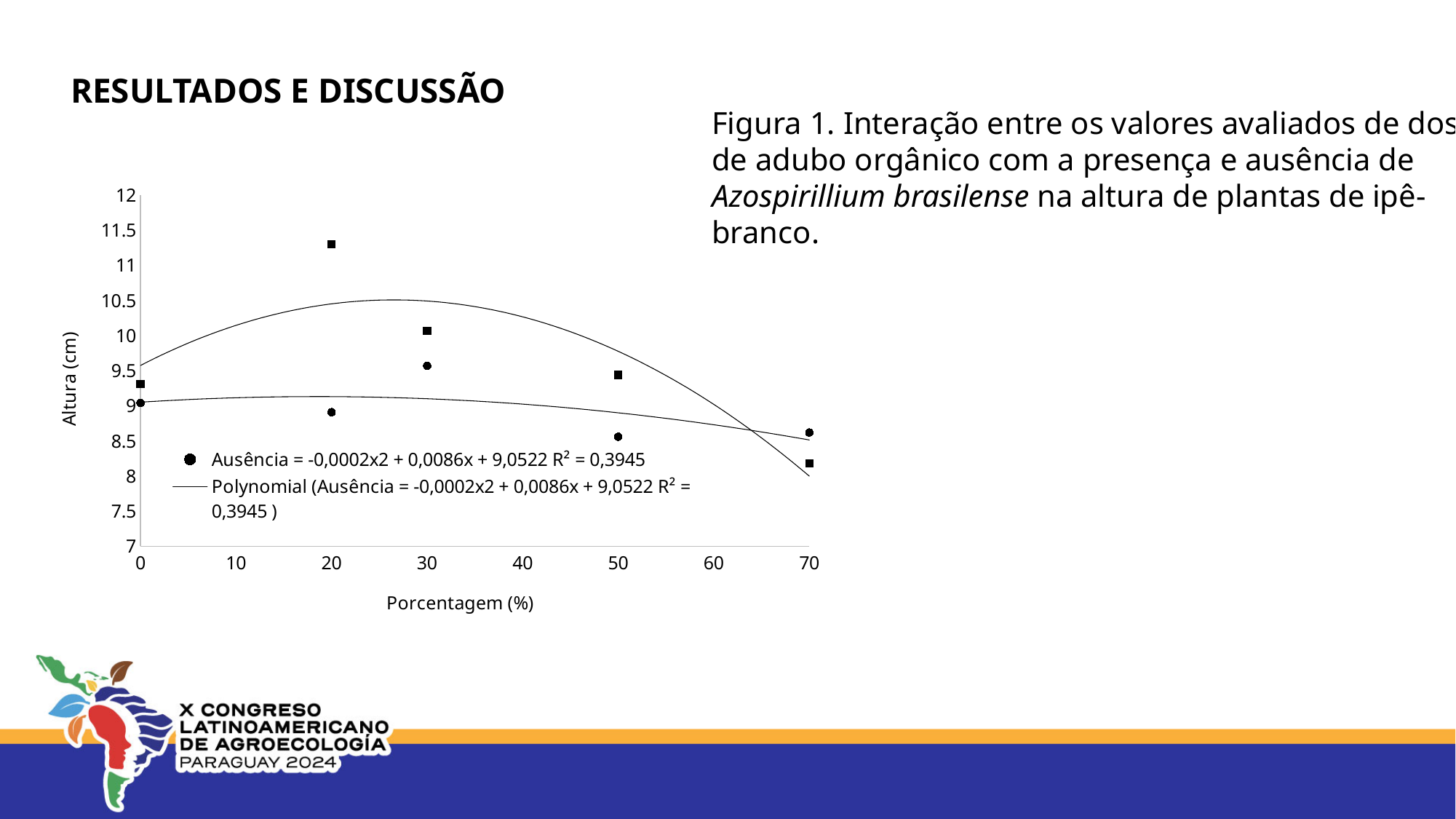
What R² value is given in the legend for the Ausência series? 0,3945 Is the Ausência (circle) value at 70% greater or less than 9? less Is the Ausência (circle) value at 20% greater or less than 9.5? less What kind of chart is shown on the slide? scatter chart At which percentage does the square-marker series reach its lowest value? 70 At 30%, which is higher: the square-marker point or the Ausência (circle) point? the square-marker point Is the square-marker value at 20% greater or less than 11? greater What is the label of the vertical axis of the chart? Altura (cm) At which percentage does the Ausência (circle) series reach its highest value? 30 At which percentage does the square-marker series reach its highest value? 20 How many entries does the chart legend list? 2 How many circle (Ausência) data points are plotted on the chart? 5